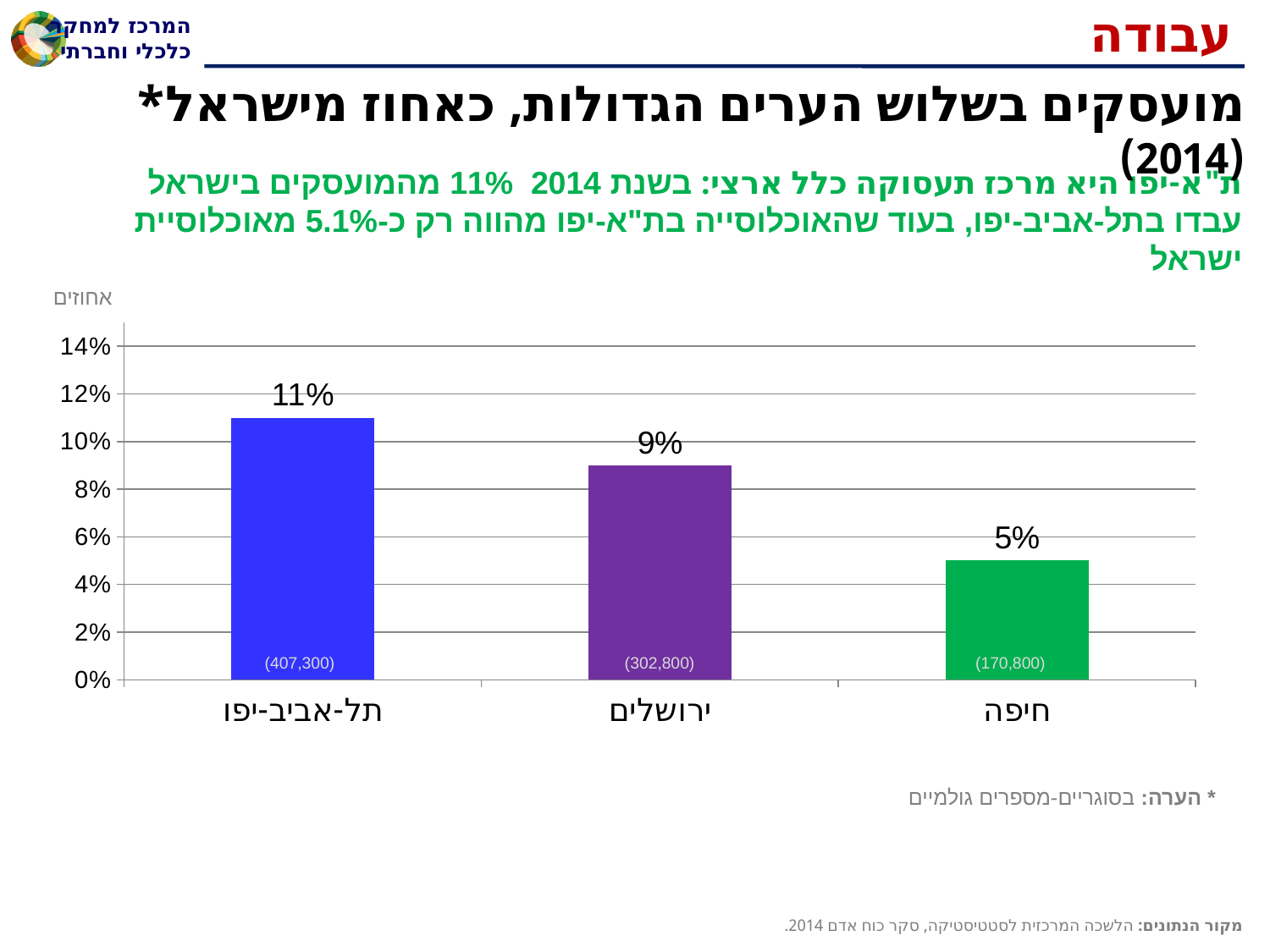
Which has a larger value, ירושלים or חיפה? ירושלים What percentage is shown for חיפה (Haifa)? 5% What percentage is shown for תל-אביב-יפו (Tel Aviv-Yafo)? 11% What is the difference in percentage points between תל-אביב-יפו and חיפה? 6% How many cities are shown in the chart? 3 Which city has the lowest percentage of employed persons? חיפה What is the label of the vertical axis? אחוזים Which city has the highest percentage of employed persons? תל-אביב-יפו What absolute number is printed inside the bar for חיפה (Haifa)? (170,800) What absolute number is printed inside the bar for ירושלים (Jerusalem)? (302,800) What type of chart is shown on the slide? Bar chart What percentage is shown for ירושלים (Jerusalem)? 9%